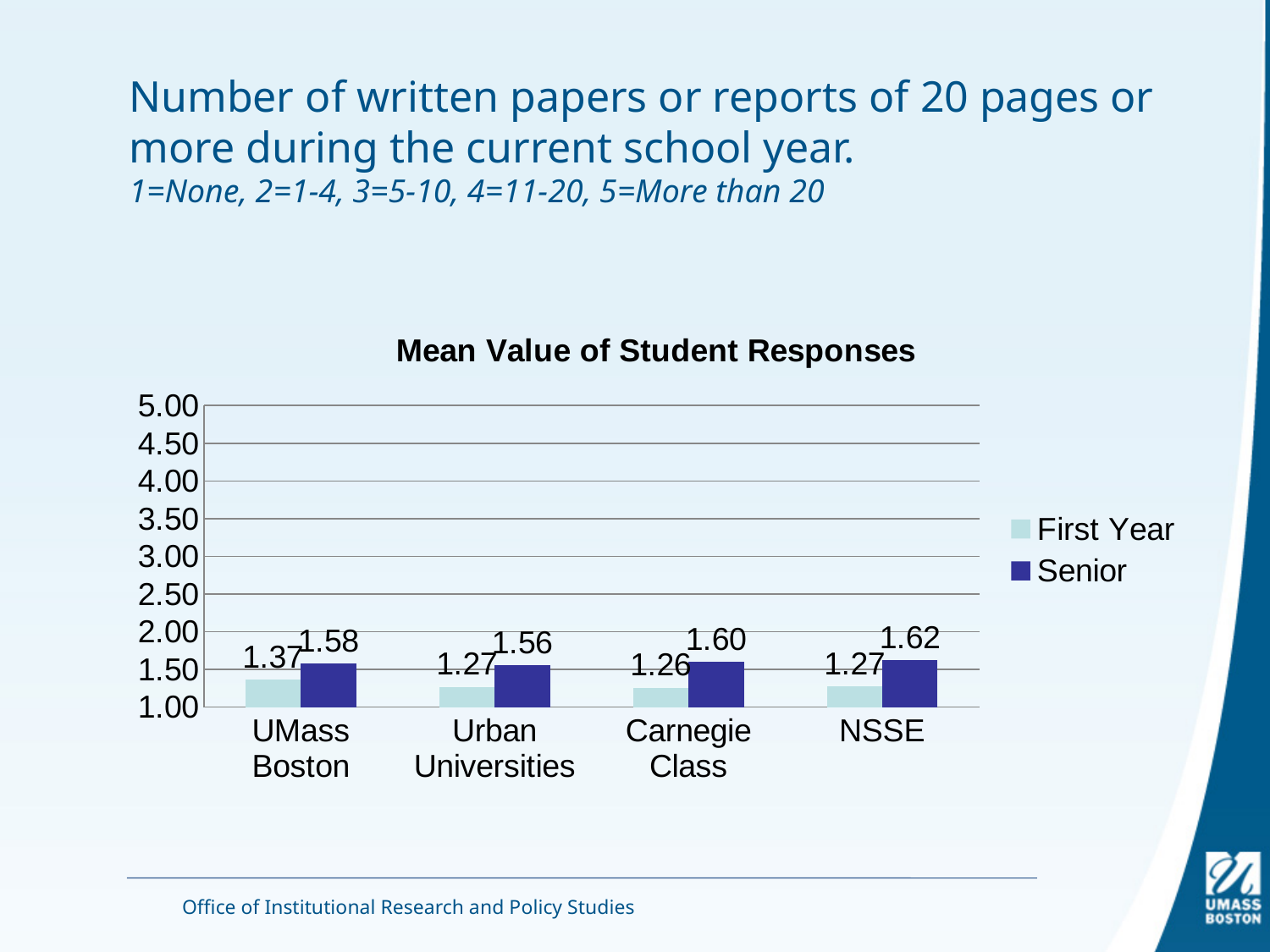
What is the difference between the Senior and First Year mean values for UMass Boston? 0.21 What is the Senior mean value for Urban Universities? 1.56 How many categories are shown on the x axis? 4 What type of chart is shown? Bar chart How many series does the legend list? 2 Which category has the highest First Year mean value? UMass Boston What is the difference between the Senior mean values for NSSE and Urban Universities? 0.06 Which is larger for Carnegie Class, the First Year or the Senior mean value? Senior What is the Senior mean value for NSSE? 1.62 What is the First Year mean value for Carnegie Class? 1.26 Which category has the highest Senior mean value? NSSE What is the First Year mean value for UMass Boston? 1.37